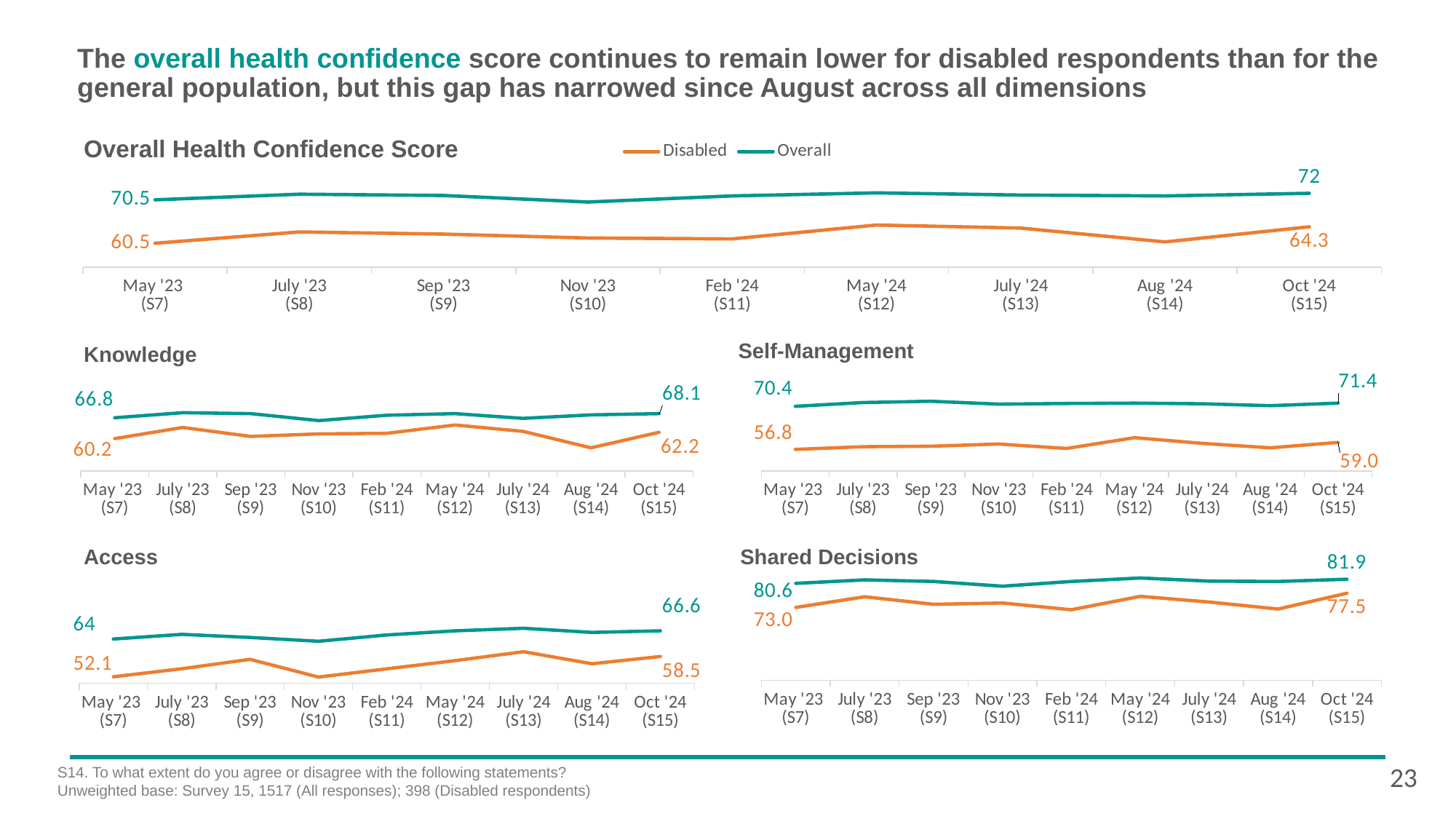
How many survey waves are plotted along the x axis of the Overall Health Confidence Score chart? 9 In the Knowledge chart, what is the Overall value for Oct '24 (S15)? 68.1 How many series does the legend of the Overall Health Confidence Score chart list? 2 In the Shared Decisions chart, what is the Disabled value for Oct '24 (S15)? 77.5 In the Overall Health Confidence Score chart, what is the Overall value for May '23 (S7)? 70.5 In the Shared Decisions chart, which series has the higher value at Oct '24 (S15), Disabled or Overall? Overall What type of chart is the Access chart? Line chart In the Overall Health Confidence Score chart, what is the difference between the Overall and Disabled values at Oct '24 (S15)? 7.7 In the Self-Management chart, what is the Disabled value for May '23 (S7)? 56.8 In the Access chart, by how much did the Disabled value change from May '23 (S7) to Oct '24 (S15)? 6.4 In the Overall Health Confidence Score chart, what is the Disabled value for Oct '24 (S15)? 64.3 In the Access chart, does the Disabled series rise or fall from May '23 (S7) to Oct '24 (S15)? Rise